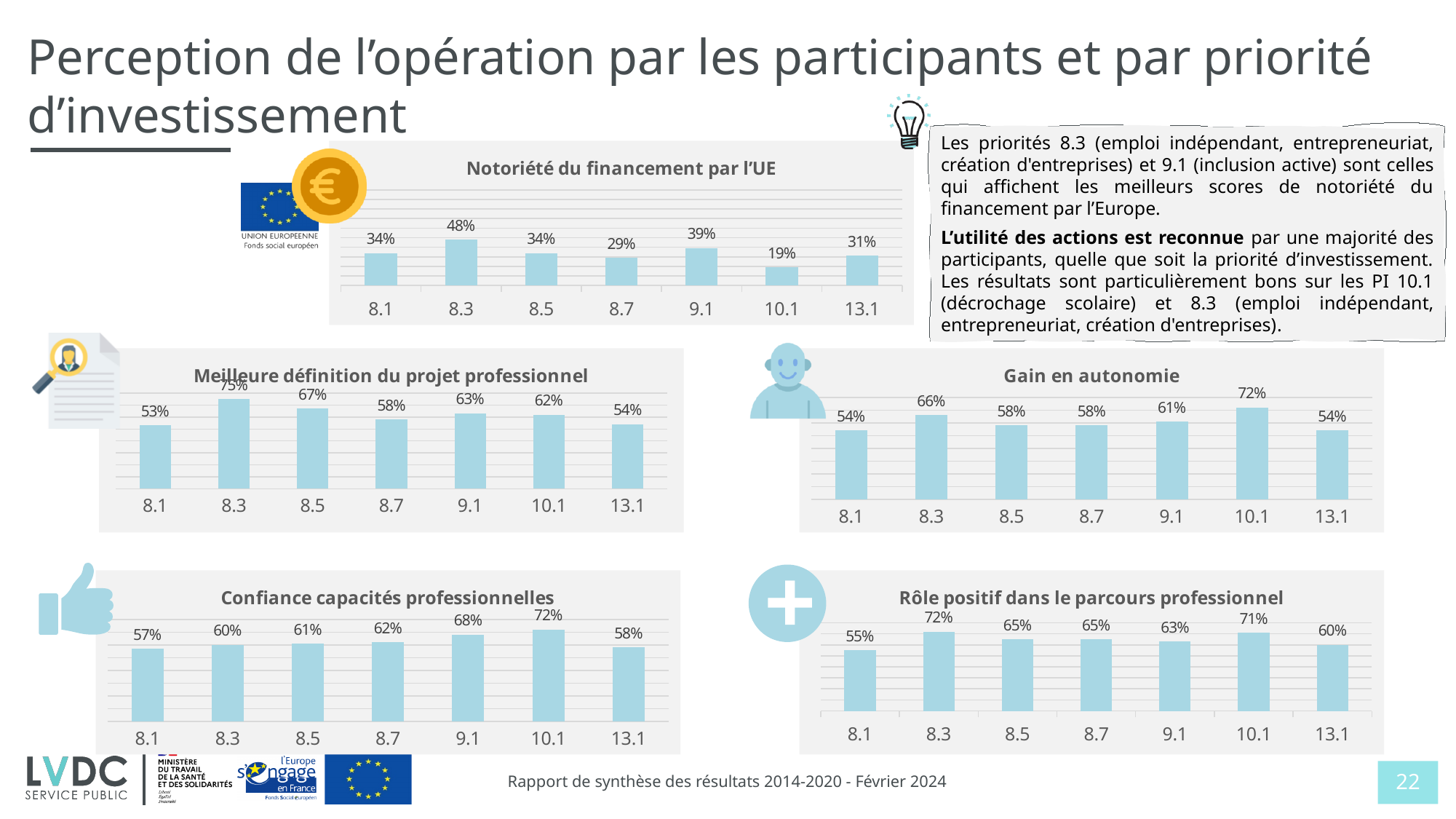
In the chart 'Confiance capacités professionnelles', what is the value for 13.1? 58% In the chart 'Gain en autonomie', what is the value for 10.1? 72% In the chart 'Rôle positif dans le parcours professionnel', which category has the lowest value? 8.1 In the chart 'Meilleure définition du projet professionnel', which category has the highest value? 8.3 What kind of chart is 'Gain en autonomie'? Bar chart In the chart 'Notoriété du financement par l'UE', what is the value for 8.3? 48% In the chart 'Notoriété du financement par l'UE', what is the difference between the values for 8.3 and 10.1? 29% How many categories are shown on the x axis of the chart 'Rôle positif dans le parcours professionnel'? 7 In the chart 'Meilleure définition du projet professionnel', what is the value for 9.1? 63% In the chart 'Gain en autonomie', which is larger, the value for 8.3 or the value for 9.1? 8.3 In the chart 'Confiance capacités professionnelles', what is the difference between the values for 10.1 and 8.1? 15% In the chart 'Notoriété du financement par l'UE', which category has the lowest value? 10.1